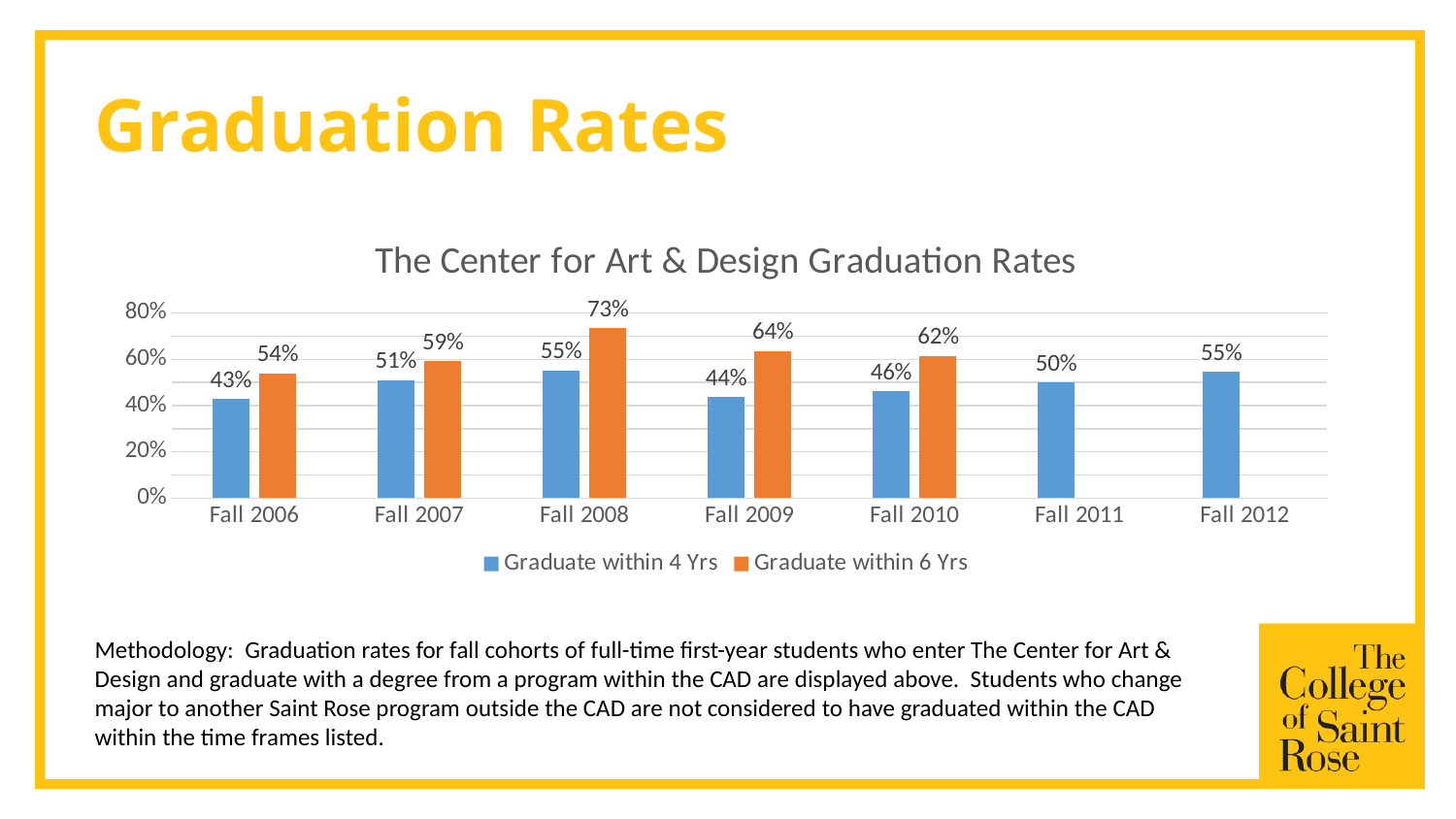
Which cohort has the lowest 'Graduate within 4 Yrs' rate? Fall 2006 How many series does the legend list? 2 What kind of chart is shown? Bar chart What is the 'Graduate within 4 Yrs' rate for Fall 2012? 55% What is the difference between the 'Graduate within 6 Yrs' and 'Graduate within 4 Yrs' rates for Fall 2009? 20% What is the title of the chart? The Center for Art & Design Graduation Rates What is the 'Graduate within 4 Yrs' rate for Fall 2006? 43% What is the 'Graduate within 6 Yrs' rate for Fall 2008? 73% Which cohort has the highest 'Graduate within 6 Yrs' rate? Fall 2008 Is the 'Graduate within 6 Yrs' rate for Fall 2010 greater or less than 40%? greater How many cohorts are shown on the x axis? 7 Which is larger: the 'Graduate within 4 Yrs' rate for Fall 2008 or for Fall 2010? Fall 2008